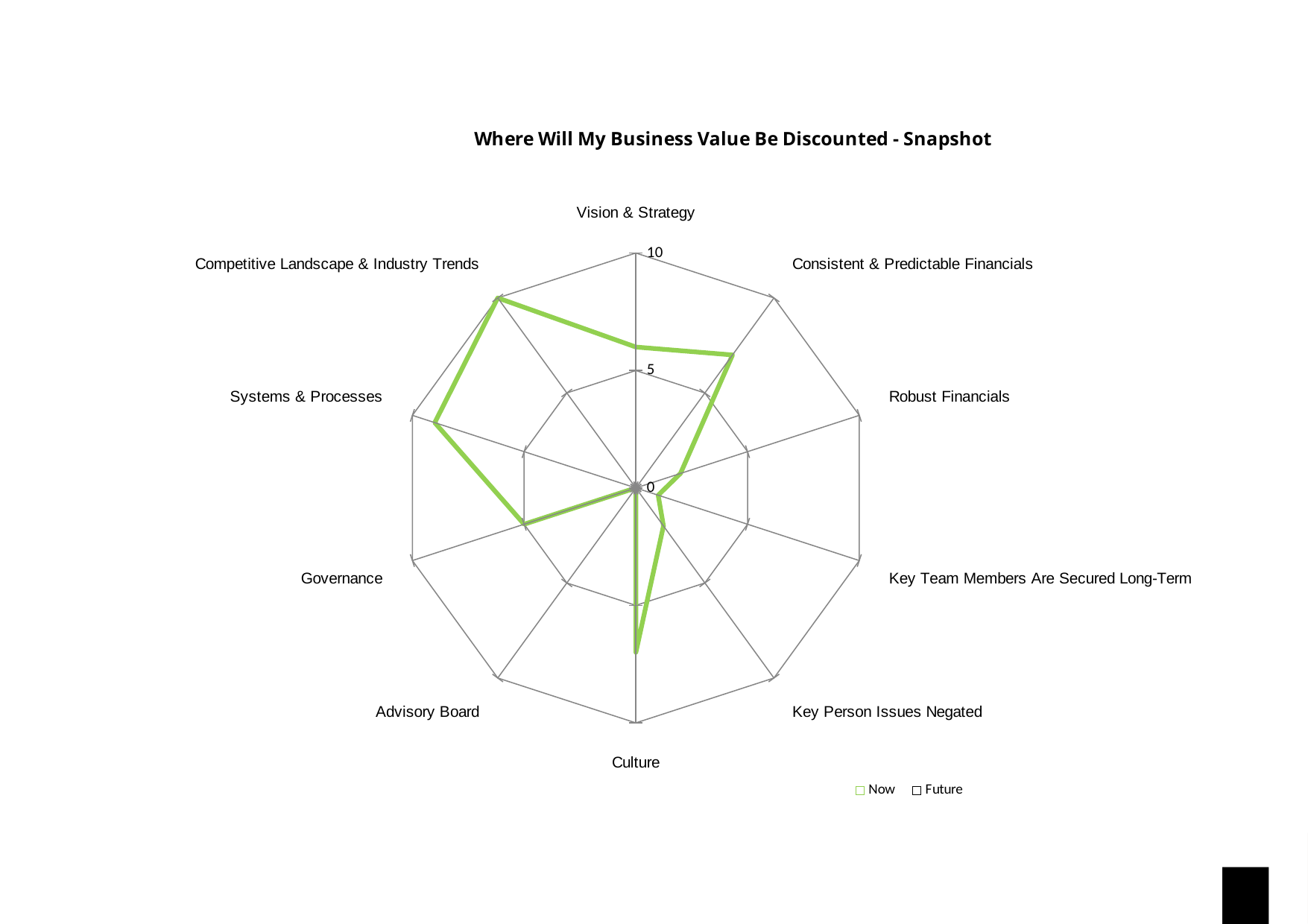
What kind of chart is shown on the slide? Radar chart How many categories (axes) does the radar chart have? 10 Is the Now value for Key Team Members Are Secured Long-Term greater or less than 5? less Is the Now value for Systems & Processes greater or less than 5? greater Is the Now value for Competitive Landscape & Industry Trends greater or less than 5? greater Which two series are listed in the legend? Now and Future Which has the larger Now value: Culture or Robust Financials? Culture Which has the larger Now value: Competitive Landscape & Industry Trends or Key Team Members Are Secured Long-Term? Competitive Landscape & Industry Trends What is the title of the chart? Where Will My Business Value Be Discounted - Snapshot How many series does the legend list? 2